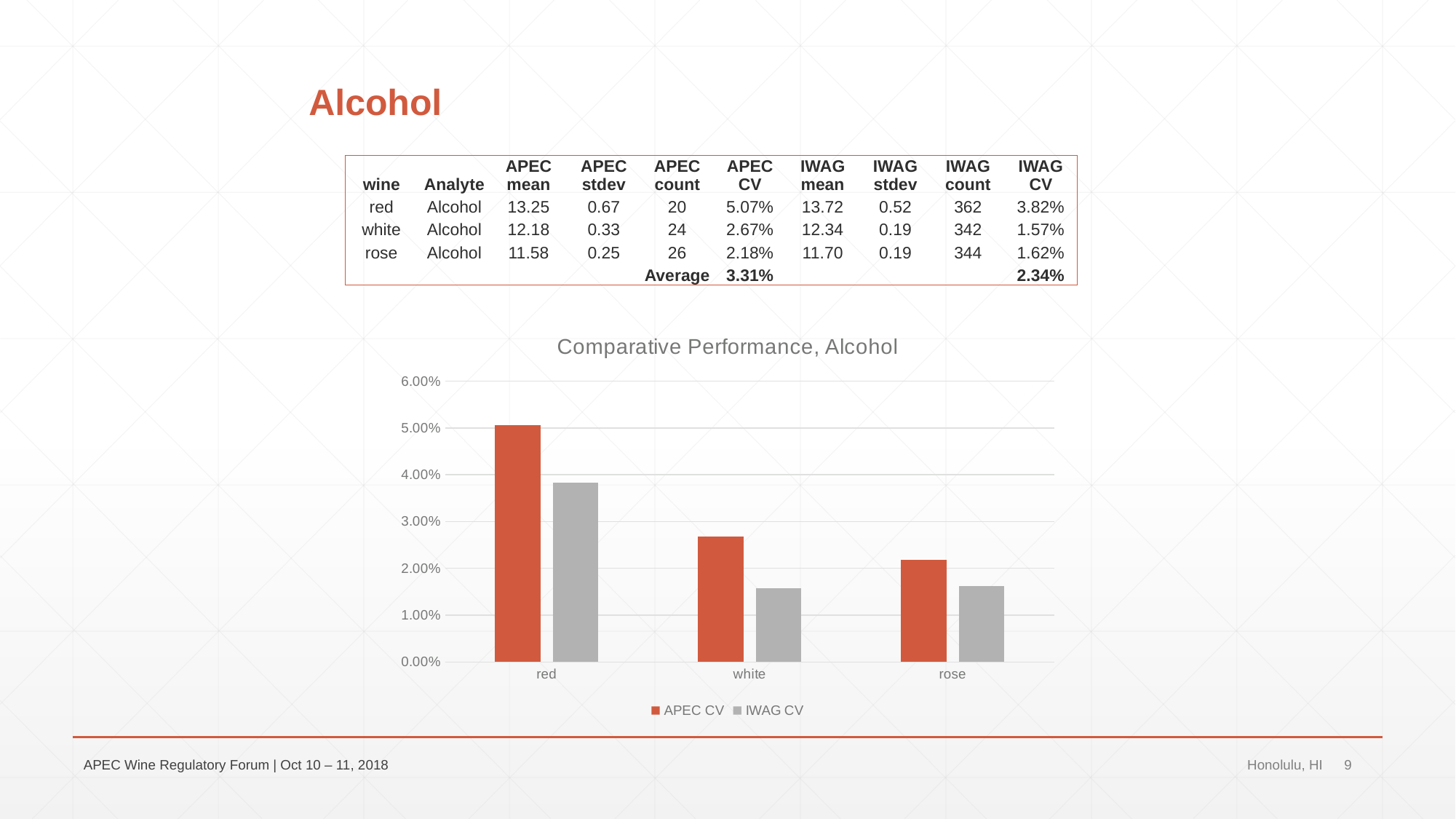
What is the title of the chart? Comparative Performance, Alcohol How many wine categories are shown on the x axis of the chart? 3 What is the difference between the APEC CV and the IWAG CV for red wine? 1.25% Which is larger for rose wine, the APEC CV or the IWAG CV? APEC CV Which wine has the lowest IWAG CV? white Which wine has the highest APEC CV? red What is the APEC CV value for red wine? 5.07% Is the IWAG CV for rose wine greater or less than 2.00%? less What is the IWAG CV value for white wine? 1.57% How many series does the chart legend list? 2 What type of chart is shown on the slide? bar chart Is the APEC CV for red wine greater or less than 5.00%? greater